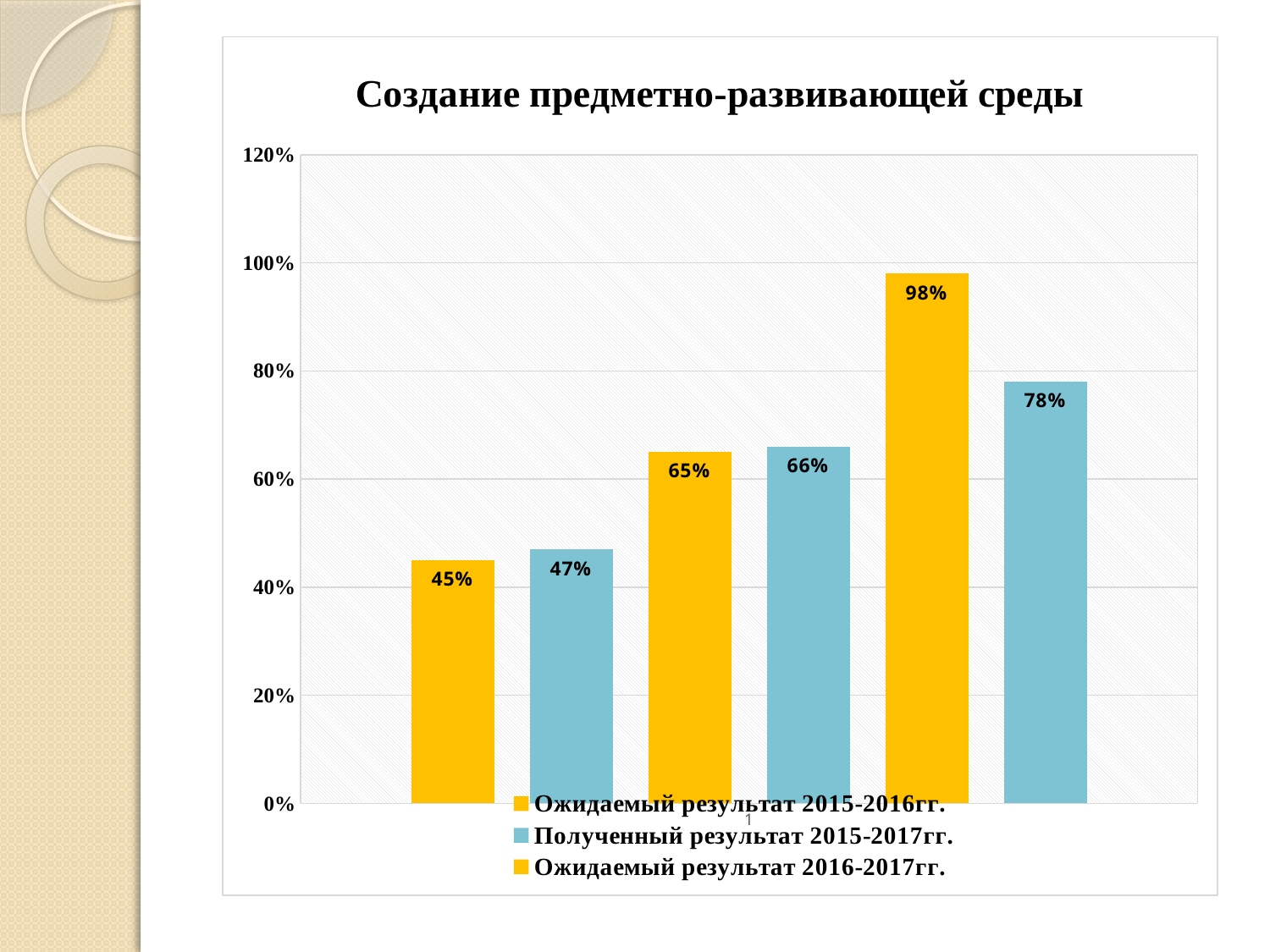
What is the title of the chart? Создание предметно-развивающей среды How many bars are plotted in the chart? 6 What is the value of the last (rightmost) bar? 78% Which is larger: the third bar from the left or the fourth bar from the left? the fourth bar (66%) What is the value of the first (leftmost) bar? 45% How many series does the legend list? 3 What is the difference between the tallest bar (98%) and the rightmost bar (78%)? 20% Which legend entry is shown in blue? Полученный результат 2015-2017гг. What is the value of the shortest bar? 45% What type of chart is shown on the slide? bar chart Is the value of the fifth bar from the left greater or less than 80%? greater What is the value of the tallest bar? 98%